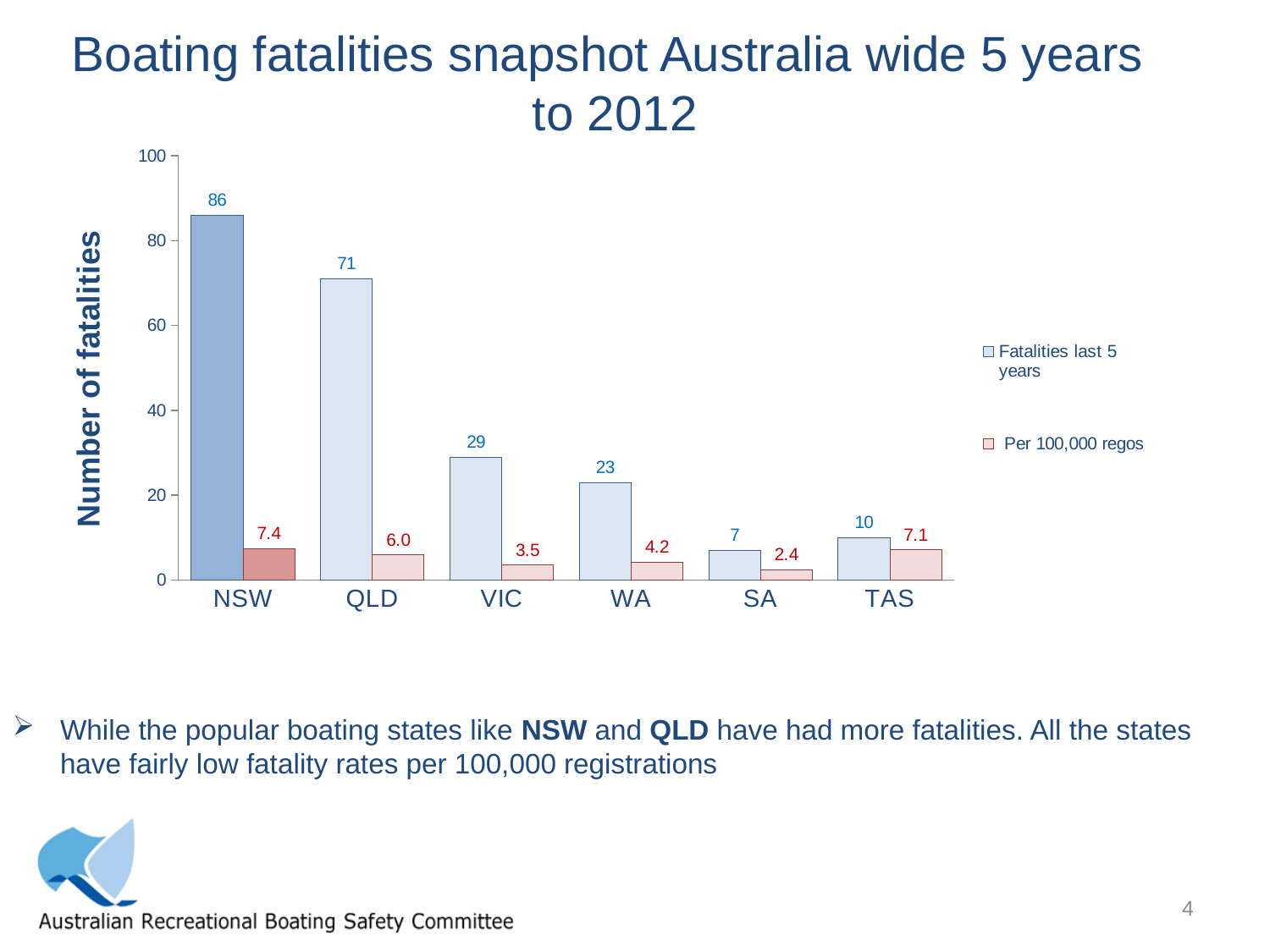
Is the value of Fatalities last 5 years for QLD greater or less than 60? greater What is the value of Fatalities last 5 years for WA? 23 Which state has the highest number of Fatalities last 5 years? NSW Which is larger, the Per 100,000 regos value for NSW or for TAS? NSW What kind of chart is shown on the slide? Bar chart What is the value of Fatalities last 5 years for NSW? 86 How many series does the legend list? 2 What is the label of the y axis? Number of fatalities What is the value of Per 100,000 regos for VIC? 3.5 How many states are shown on the x axis? 6 What is the difference in Fatalities last 5 years between NSW and QLD? 15 Which state has the lowest value for Per 100,000 regos? SA